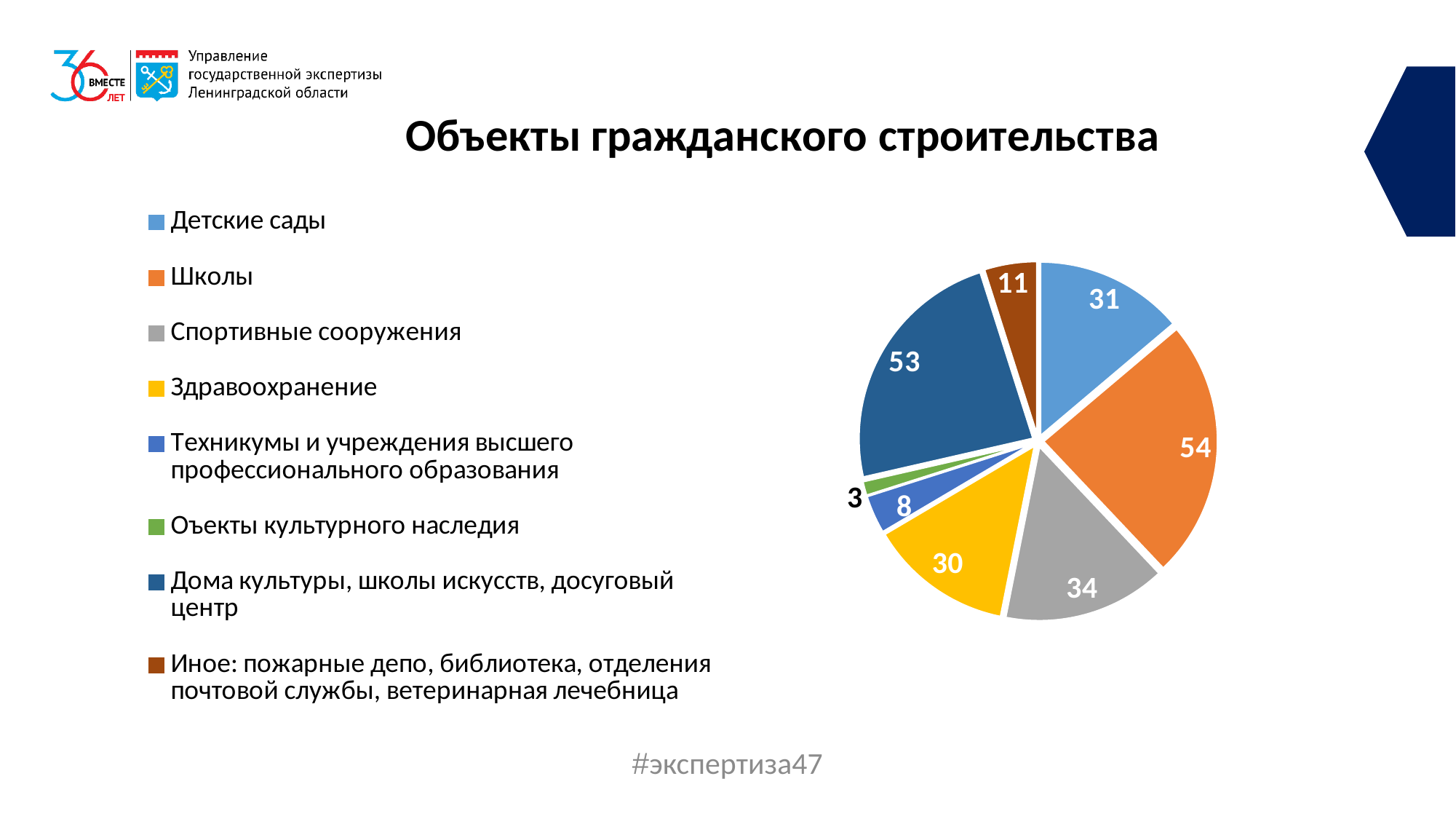
Which category has the largest slice in the pie chart? Школы What is the value for Детские сады? 31 Which is larger: the value for Техникумы и учреждения высшего профессионального образования or the value for Иное? Иное What is the value for Дома культуры, школы искусств, досуговый центр? 53 What is the value for Объекты культурного наследия? 3 What kind of chart is shown on the slide? pie chart How many categories does the pie chart have? 8 What is the value for Школы in the pie chart? 54 What is the value for Здравоохранение? 30 What is the difference between the values for Спортивные сооружения and Здравоохранение? 4 Which category has the smallest slice in the pie chart? Объекты культурного наследия What is the title of the chart on the slide? Объекты гражданского строительства